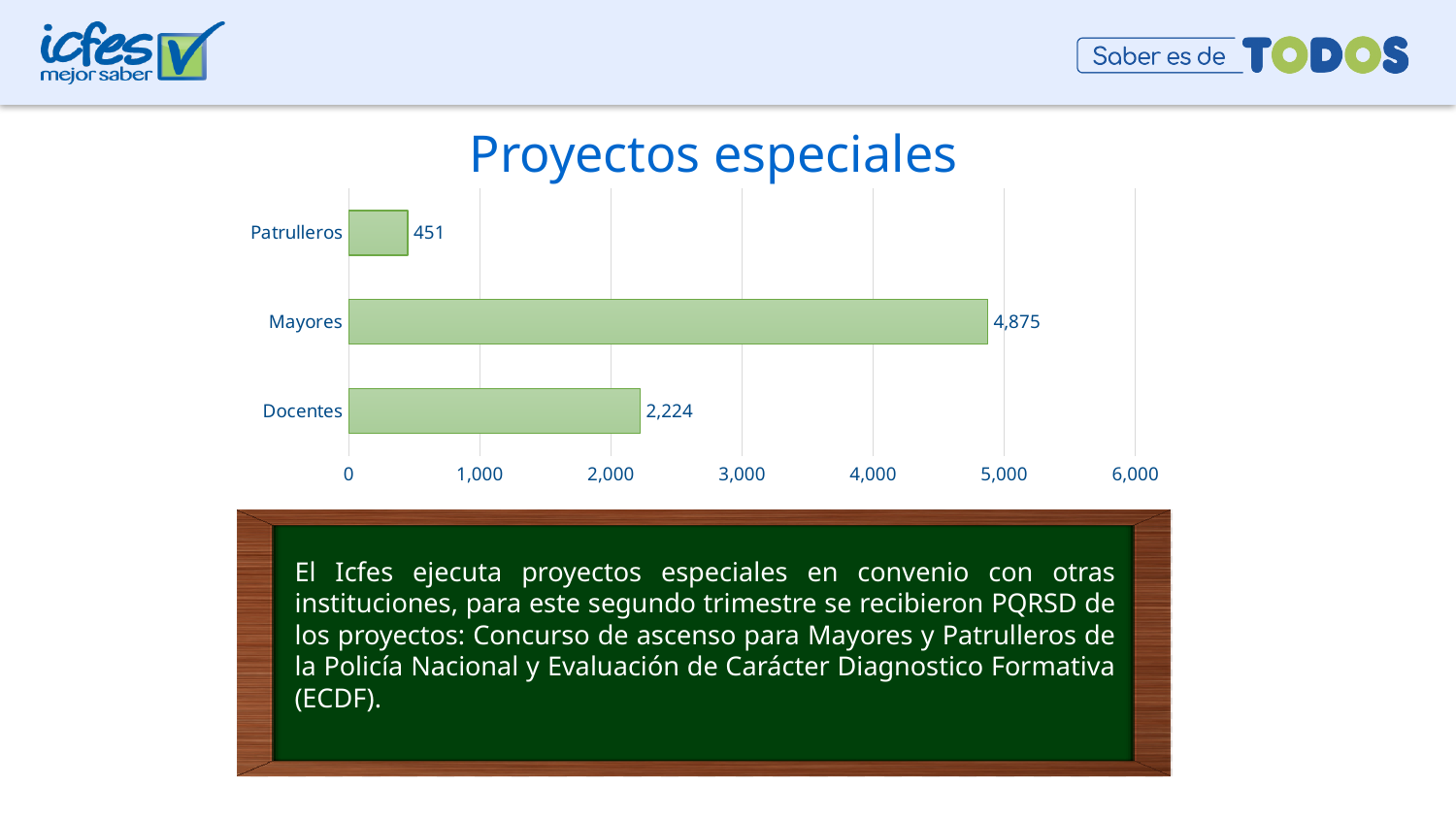
What is the difference between the values for Mayores and Docentes? 2,651 Is the value for Mayores greater or less than 4,000? greater What kind of chart is shown on the slide? bar chart What is the value for Docentes? 2,224 Which is larger, the value for Docentes or the value for Patrulleros? Docentes Which category has the highest value? Mayores How many categories are shown in the chart? 3 Which category has the lowest value? Patrulleros What is the difference between the values for Docentes and Patrulleros? 1,773 What is the title of the chart? Proyectos especiales What is the value for Patrulleros? 451 What is the value for Mayores? 4,875